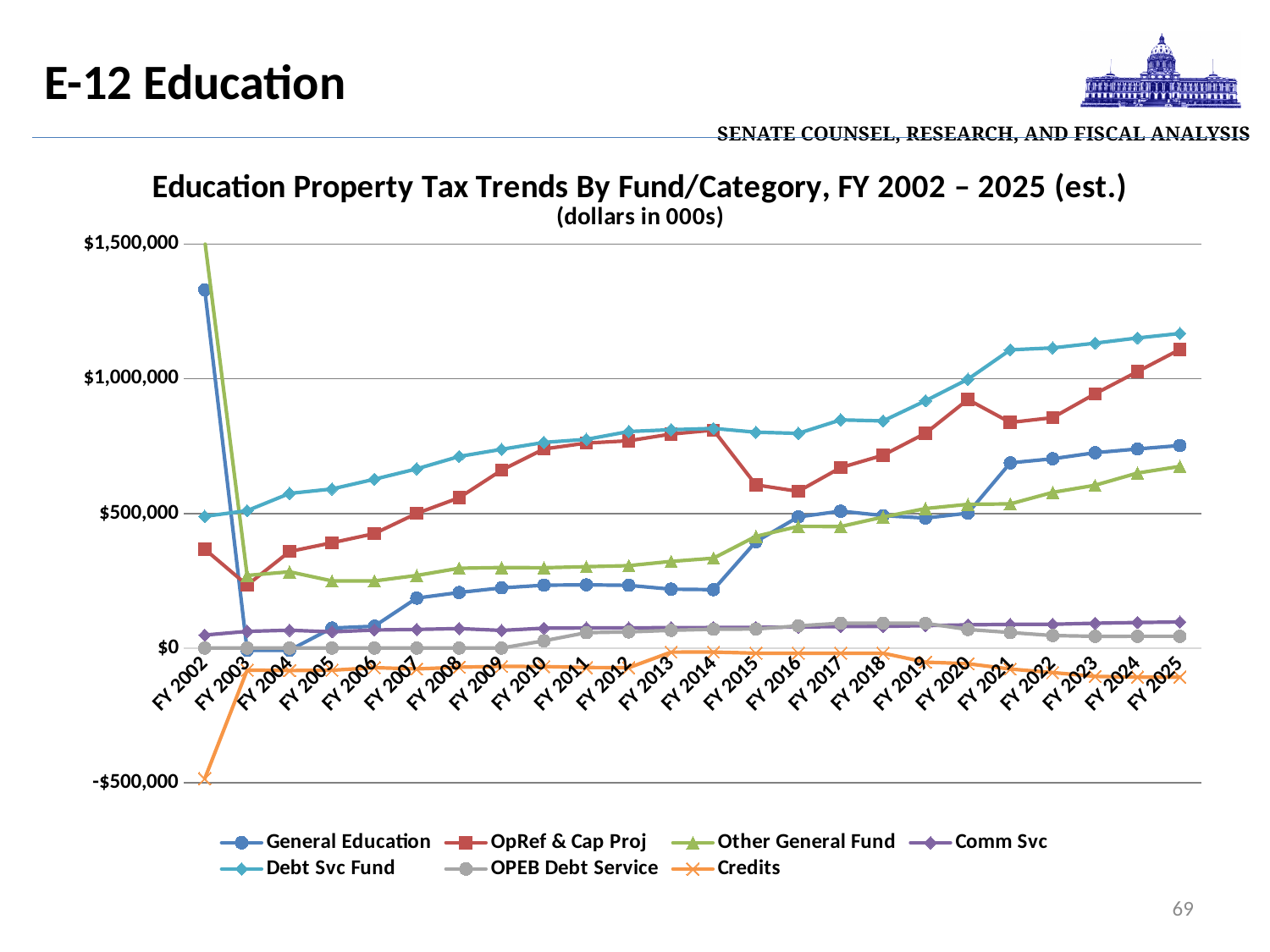
Is the value for OpRef & Cap Proj in FY 2015 greater or less than $500,000? greater In FY 2025, which is higher: Debt Svc Fund or OpRef & Cap Proj? Debt Svc Fund Does the Debt Svc Fund line generally rise or fall from FY 2003 to FY 2025? rise Is the value for Credits in FY 2002 greater or less than $0? less How many fiscal years are plotted along the x axis? 24 In FY 2025, which is higher: General Education or Other General Fund? General Education Which series has the highest value in FY 2025? Debt Svc Fund How many series does the legend list? 7 What kind of chart is shown on the slide? line chart Which series has the lowest value in FY 2002? Credits Is the value for General Education in FY 2002 greater or less than $1,000,000? greater